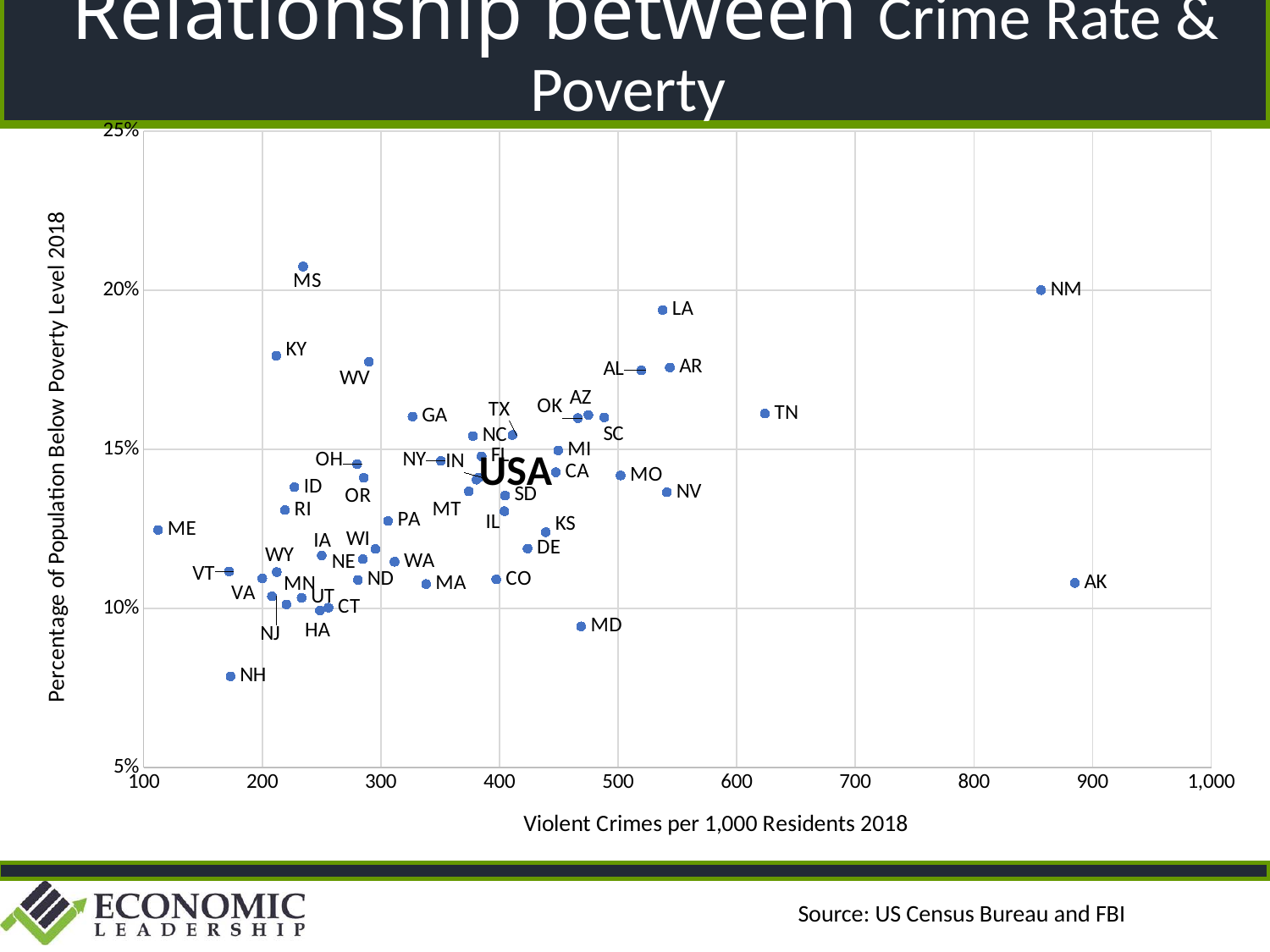
What is the title of the horizontal axis? Violent Crimes per 1,000 Residents 2018 Which state has the lowest violent crime rate? ME Is the poverty percentage for AK greater or less than 15%? less Which state has the highest percentage of population below the poverty level? MS Which state has a higher poverty percentage, LA or NV? LA Is the poverty percentage for NM greater or less than 15%? greater What kind of chart is shown on the slide? scatter plot Which state has the lowest percentage of population below the poverty level? NH Which state has a higher violent crime rate, TN or GA? TN Is the violent crime rate for TN greater or less than 600? greater What is the title of the vertical axis? Percentage of Population Below Poverty Level 2018